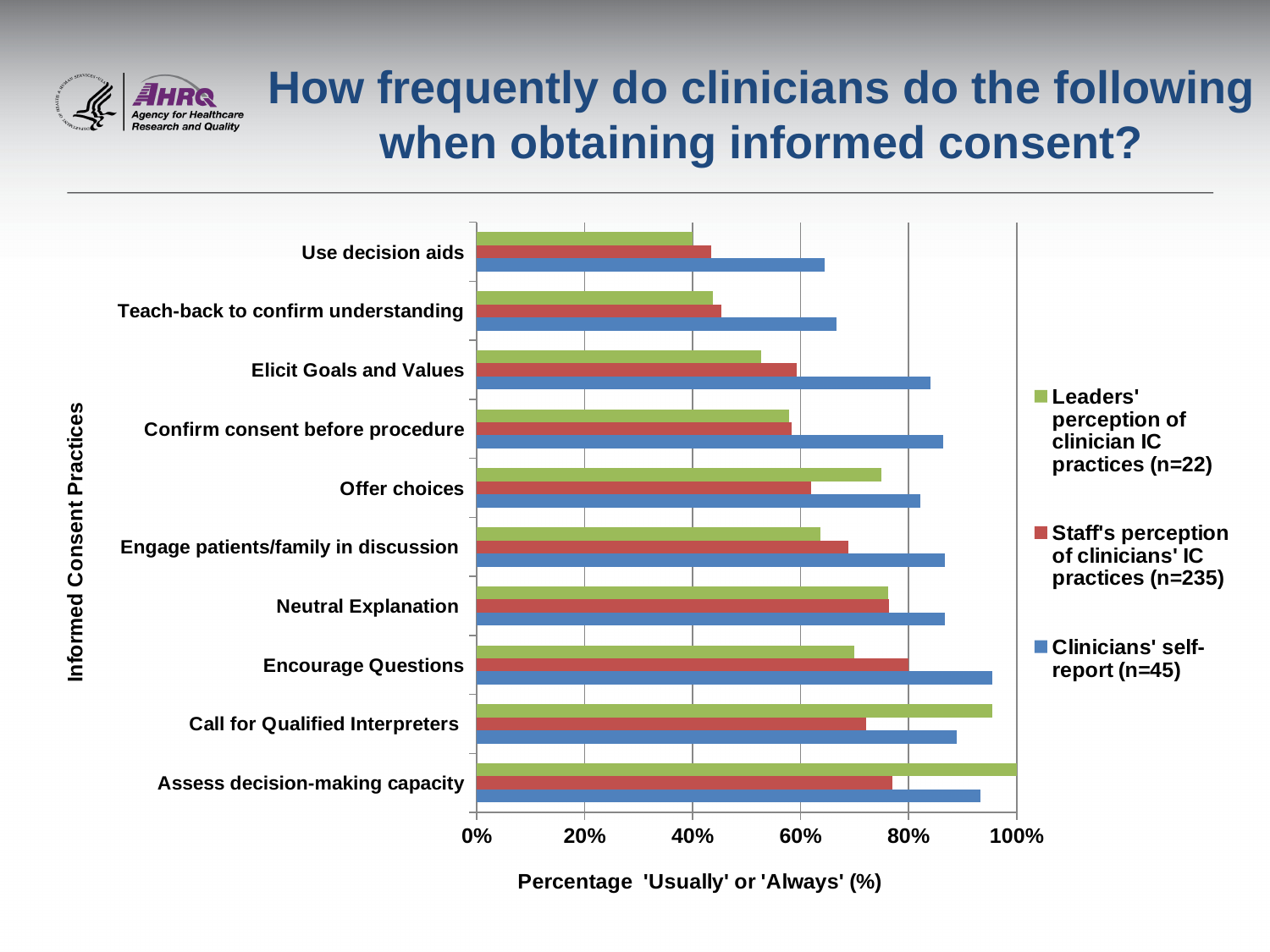
For Call for Qualified Interpreters, which is larger: Leaders' perception or Staff's perception? Leaders' perception How many series does the legend list? 3 Is the Clinicians' self-report value for Encourage Questions greater or less than 80%? greater Is the Clinicians' self-report value for Elicit Goals and Values greater or less than 80%? greater What kind of chart is shown on the slide? bar chart What is the Leaders' perception value for Assess decision-making capacity? 100% What is the title of the horizontal axis? Percentage 'Usually' or 'Always' (%) For Use decision aids, which is larger: Clinicians' self-report or Staff's perception? Clinicians' self-report Which category has the highest value for Leaders' perception of clinician IC practices? Assess decision-making capacity Is the Staff's perception value for Teach-back to confirm understanding greater or less than 60%? less How many informed consent practices (categories) are plotted on the chart? 10